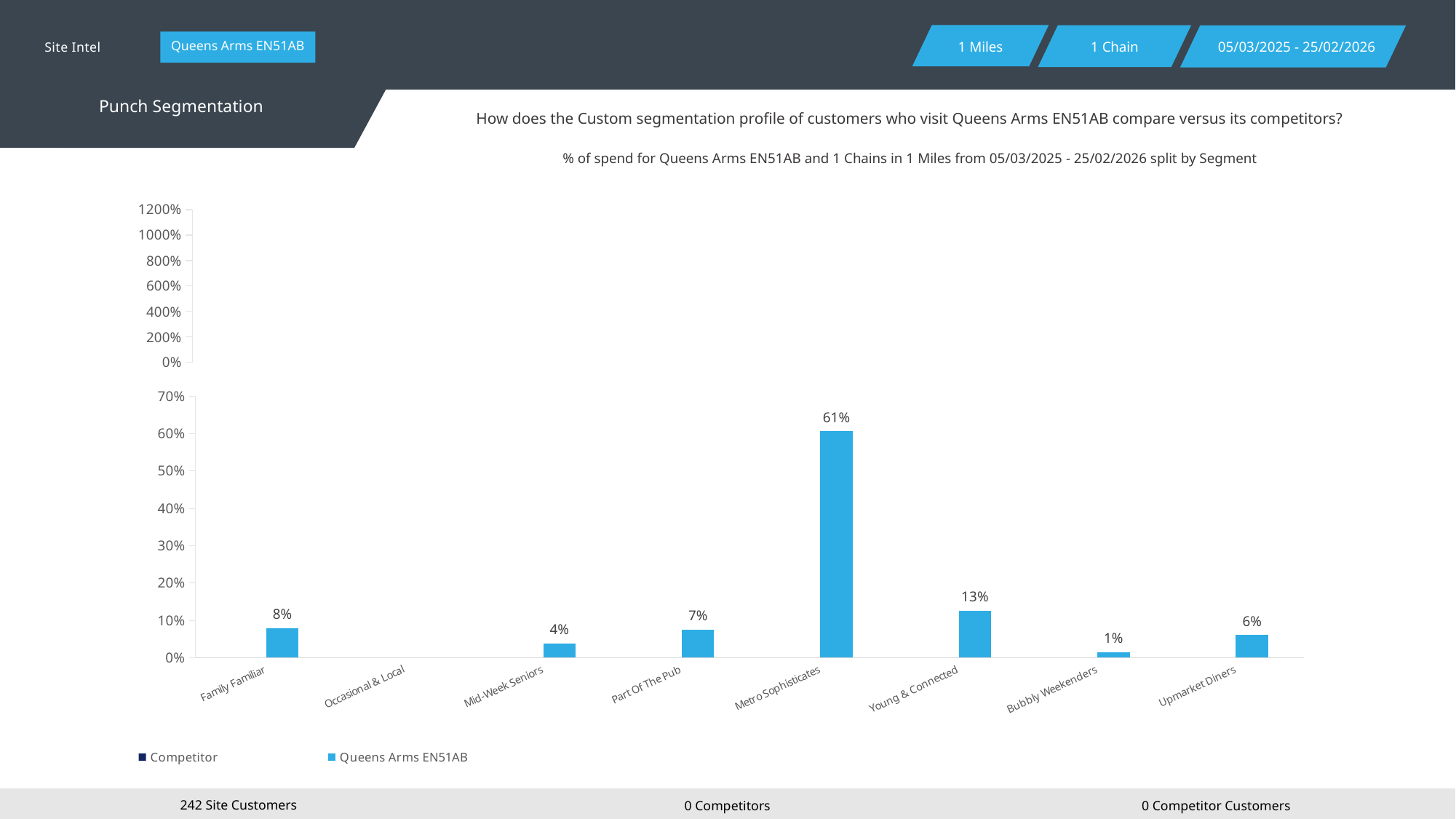
In the lower bar chart, what is the % of spend for Queens Arms EN51AB in the Metro Sophisticates segment? 61% In the lower bar chart, what is the % of spend for Queens Arms EN51AB in the Bubbly Weekenders segment? 1% What kind of chart is used to show the % of spend split by segment? Bar chart In the lower bar chart, which is larger for Queens Arms EN51AB: Part Of The Pub or Mid-Week Seniors? Part Of The Pub How many segments are shown along the x axis of the lower bar chart? 8 In the lower bar chart, what is the % of spend for Queens Arms EN51AB in the Young & Connected segment? 13% In the lower bar chart, which segment has the highest % of spend for Queens Arms EN51AB? Metro Sophisticates How many series does the legend list? 2 In the lower bar chart, what is the % of spend for Queens Arms EN51AB in the Family Familiar segment? 8% In the lower bar chart, what is the difference between the Family Familiar and Upmarket Diners values for Queens Arms EN51AB? 2% In the lower bar chart, what is the difference between the Metro Sophisticates and Young & Connected values for Queens Arms EN51AB? 48% In the lower bar chart, is the value for Metro Sophisticates greater or less than 50%? greater